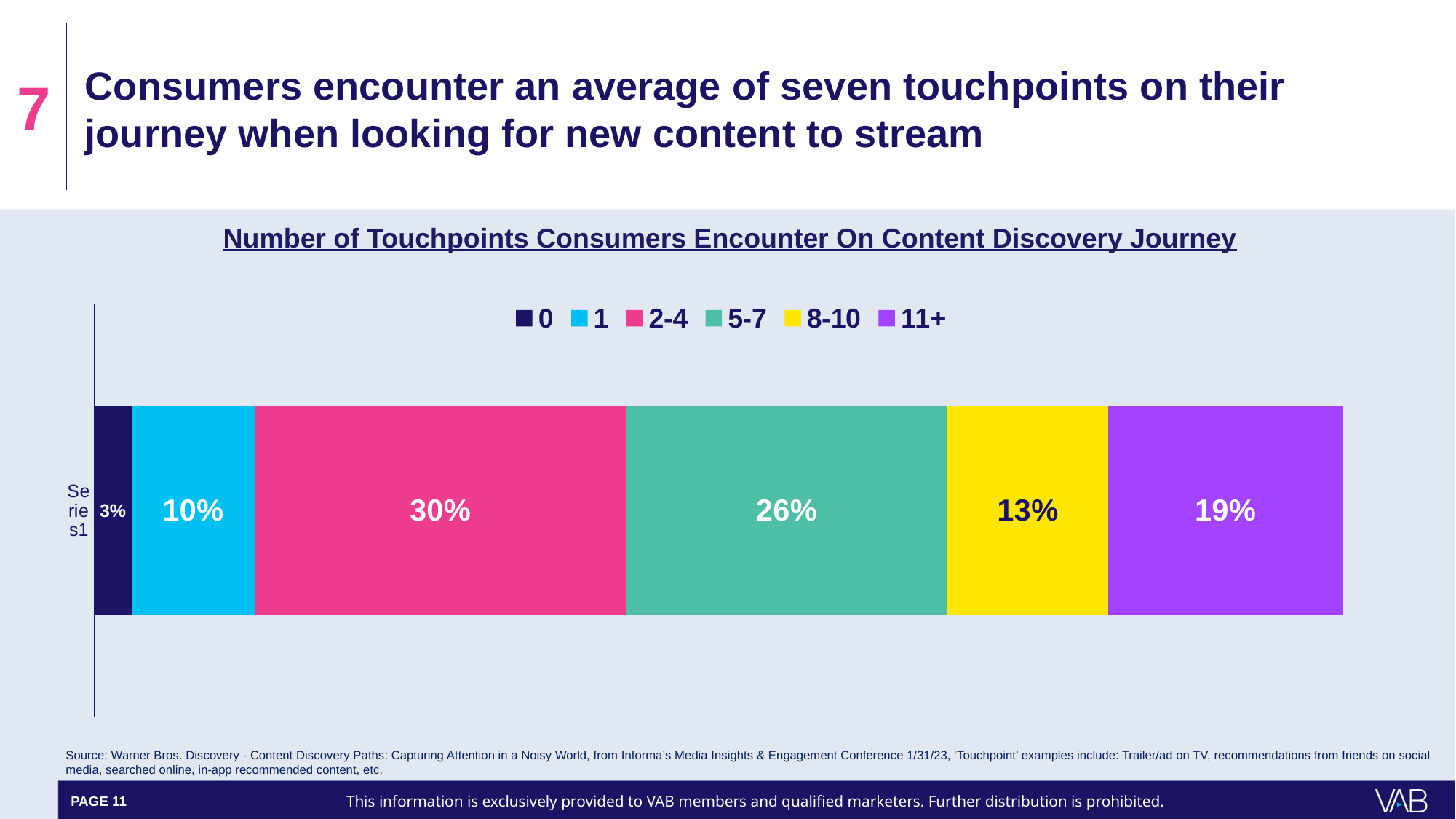
What is the difference in percentage points between the 2-4 and 5-7 touchpoint groups? 4 percentage points What percentage of consumers encounter 8-10 touchpoints? 13% What percentage of consumers encounter 2-4 touchpoints on their content discovery journey? 30% How many touchpoint groups does the legend list? 6 What is the combined percentage of consumers who encounter 1 or 2-4 touchpoints? 40% What is the title of the chart? Number of Touchpoints Consumers Encounter On Content Discovery Journey Which touchpoint group has the smallest share of consumers? 0 Which is larger, the share for 11+ touchpoints or the share for 8-10 touchpoints? 11+ What percentage of consumers encounter 11+ touchpoints? 19% What type of chart is shown on the slide? Stacked bar chart What percentage of consumers encounter 0 touchpoints? 3% Which touchpoint group has the largest share of consumers? 2-4